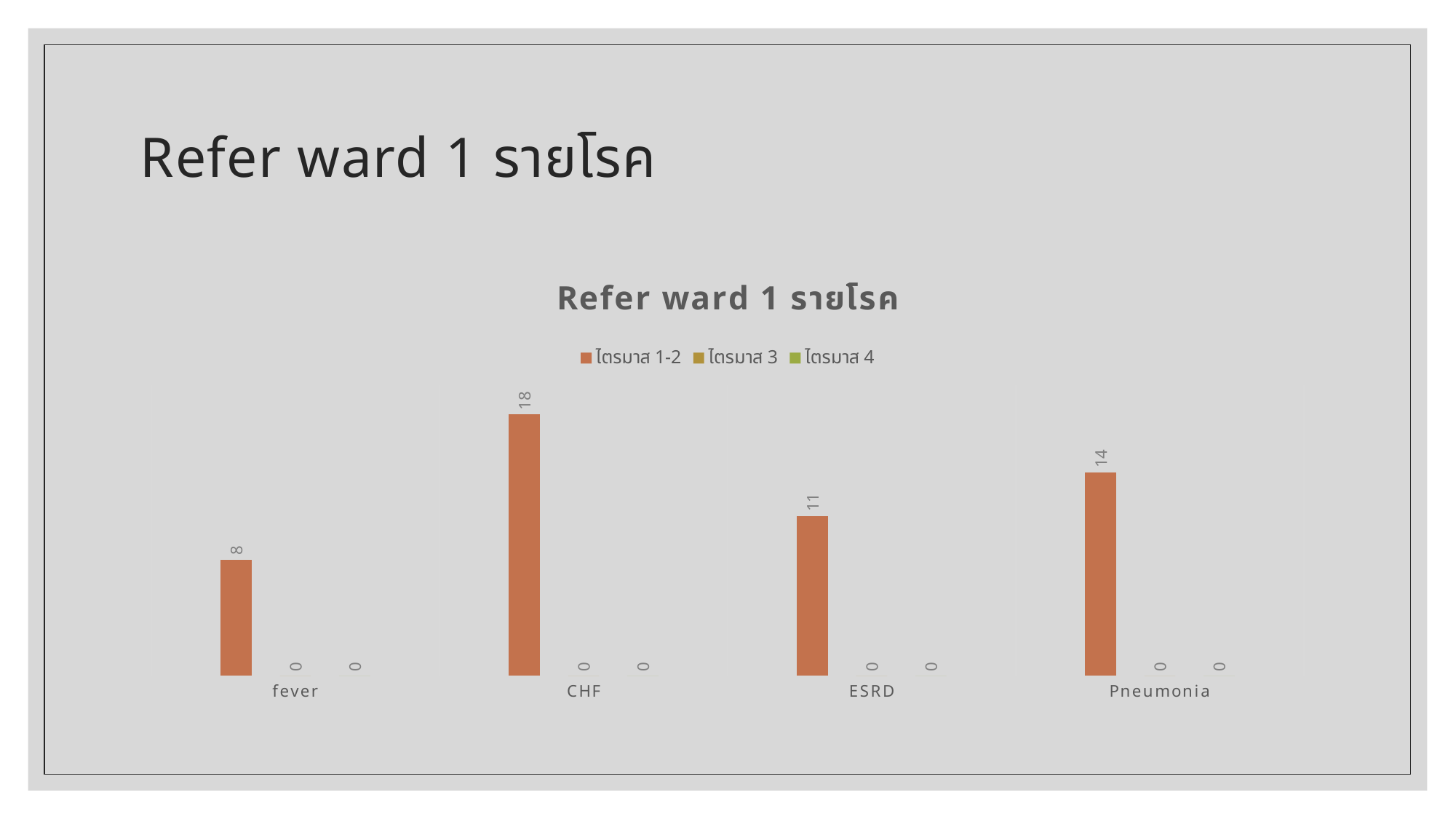
Which category has the highest value in the ไตรมาส 1-2 series? CHF What kind of chart is shown? bar chart How many categories are shown on the x axis? 4 What is the value for CHF in the ไตรมาส 1-2 series? 18 What is the value for Pneumonia in the ไตรมาส 1-2 series? 14 Which is larger in the ไตรมาส 1-2 series, Pneumonia or ESRD? Pneumonia What is the value for fever in the ไตรมาส 1-2 series? 8 What is the title of the chart? Refer ward 1 รายโรค What is the value for ESRD in the ไตรมาส 3 series? 0 How many series does the legend list? 3 Which category has the lowest value in the ไตรมาส 1-2 series? fever What is the difference between the ไตรมาส 1-2 values for CHF and ESRD? 7